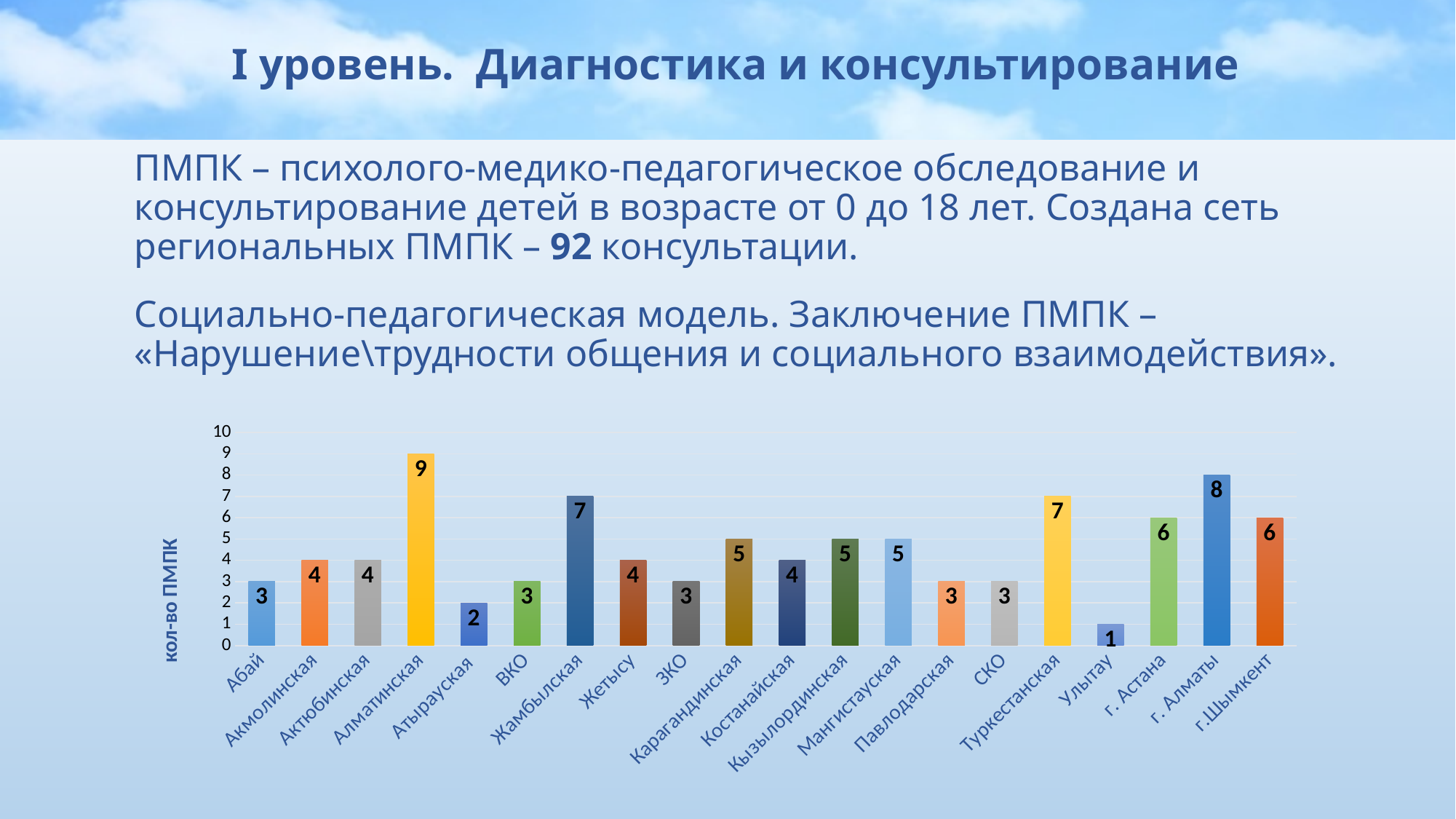
How many categories are shown on the x axis? 20 What is the value for Мангистауская? 5 What is the value for Улытау? 1 What is the difference between the values for г. Алматы and г.Шымкент? 2 What is the label of the vertical axis? кол-во ПМПК What is the difference between the values for Алматинская and Атырауская? 7 What is the value for г. Алматы? 8 What is the value for Алматинская? 9 Which is larger, the value for Жамбылская or the value for г. Астана? Жамбылская Which category has the lowest value? Улытау Which category has the highest value? Алматинская What type of chart is shown on the slide? bar chart